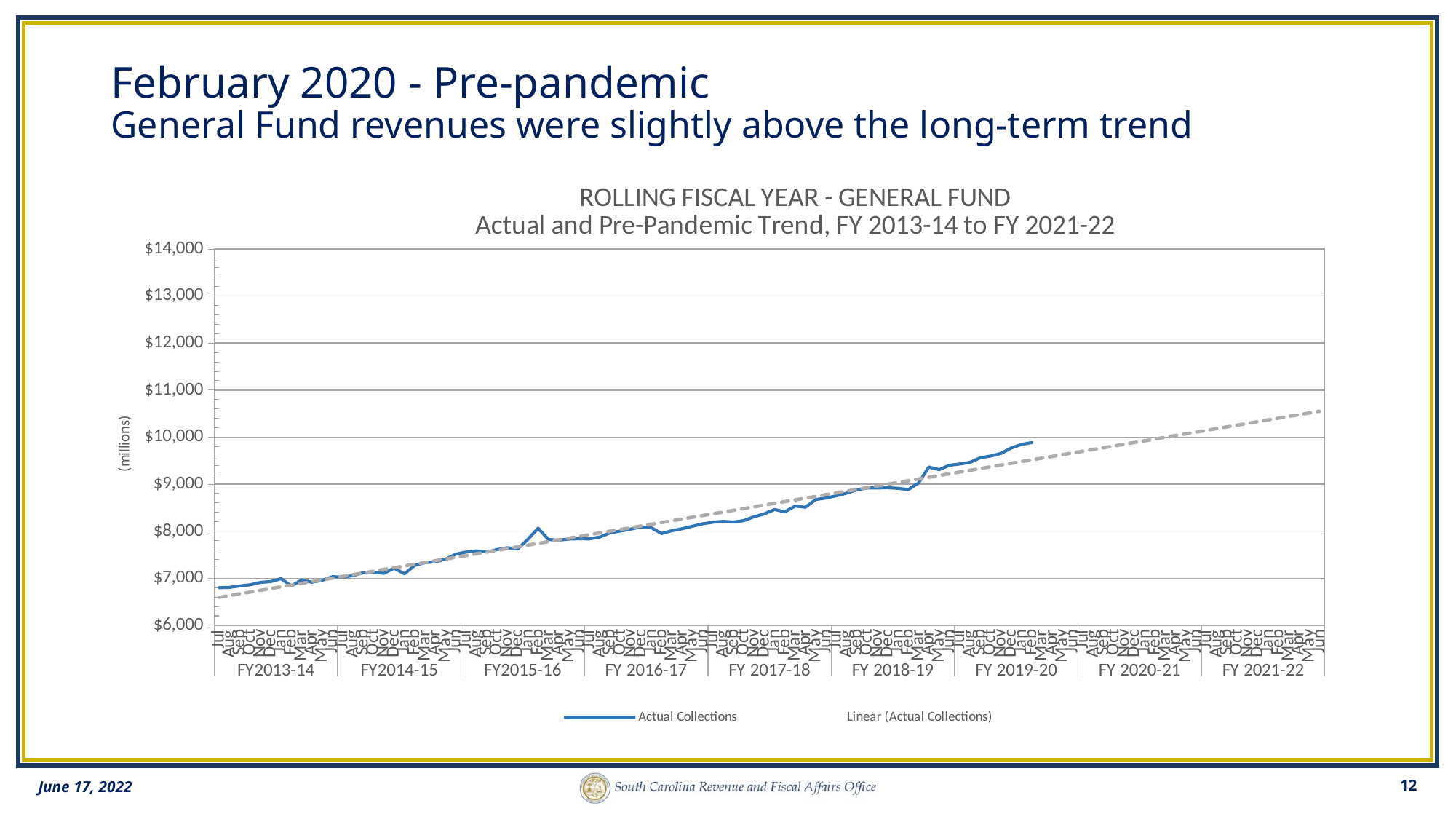
Do the Actual Collections values rise or fall from FY2013-14 to FY 2019-20? rise Is the Actual Collections value at Jul of FY2013-14 greater or less than $7,000? less What kind of chart is shown on the slide? line chart Is the Actual Collections value at Jul of FY2015-16 greater or less than $8,000? less Is the Actual Collections value at Feb of FY 2019-20 greater or less than $9,000? greater At Feb of FY 2019-20, which is higher: Actual Collections or the Linear (Actual Collections) trend line? Actual Collections What is the highest value shown on the y axis? $14,000 What are the two series named in the legend? Actual Collections and Linear (Actual Collections) How many series does the legend list? 2 How many fiscal years are labeled along the x axis? 9 What is the title of the chart? ROLLING FISCAL YEAR - GENERAL FUND Actual and Pre-Pandemic Trend, FY 2013-14 to FY 2021-22